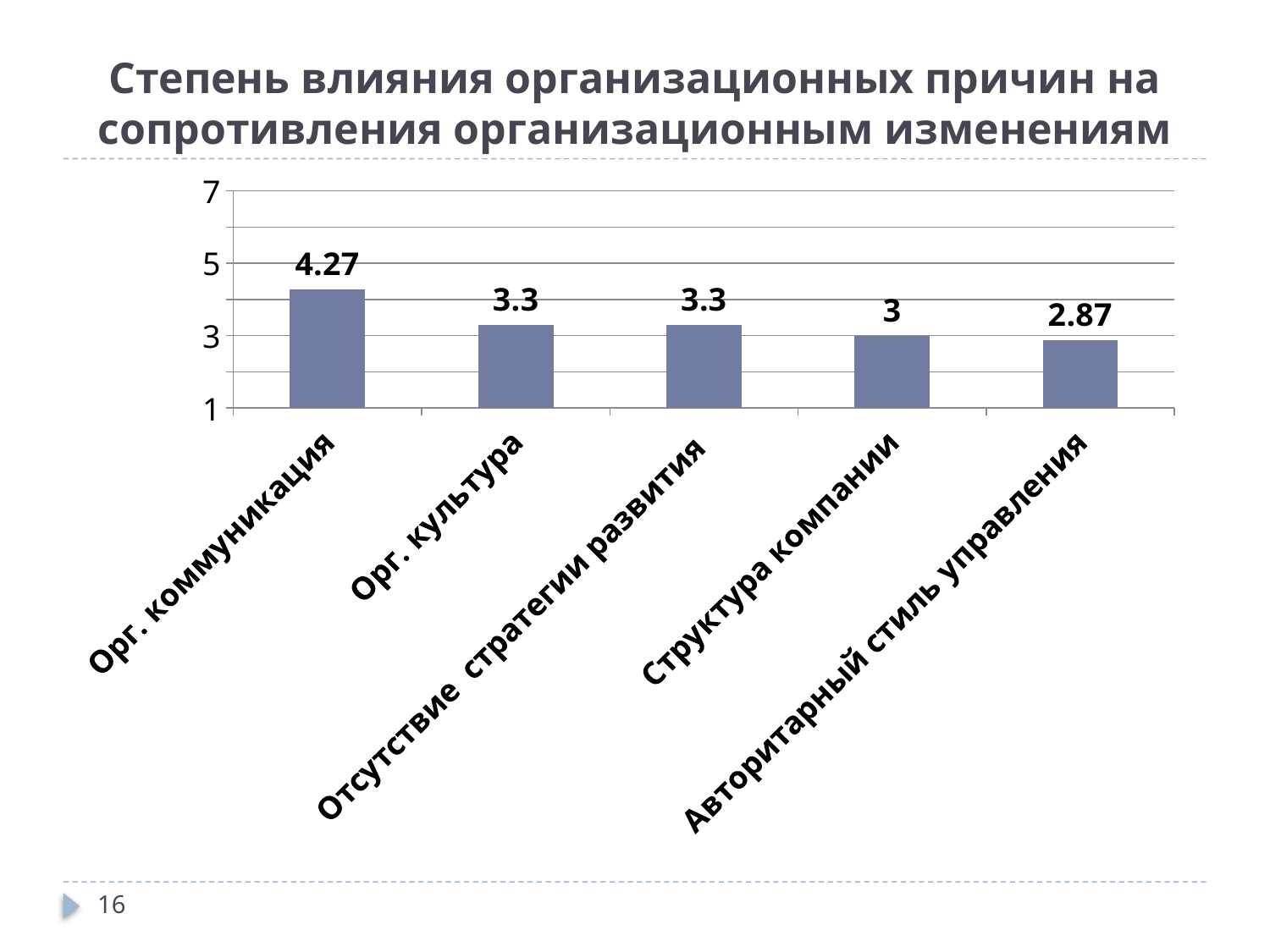
What is the difference between the values for Орг. коммуникация and Авторитарный стиль управления? 1.4 Which is larger, the value for Орг. культура or the value for Структура компании? Орг. культура How many categories are shown in the chart? 5 Which category has the highest value? Орг. коммуникация What is the value for Структура компании? 3 What is the difference between the values for Орг. культура and Структура компании? 0.3 What kind of chart is shown on the slide? bar chart What is the value for Авторитарный стиль управления? 2.87 Which category has the lowest value? Авторитарный стиль управления Is the value for Орг. коммуникация greater or less than 5? less What is the title of the slide? Степень влияния организационных причин на сопротивления организационным изменениям What is the value for Орг. коммуникация? 4.27